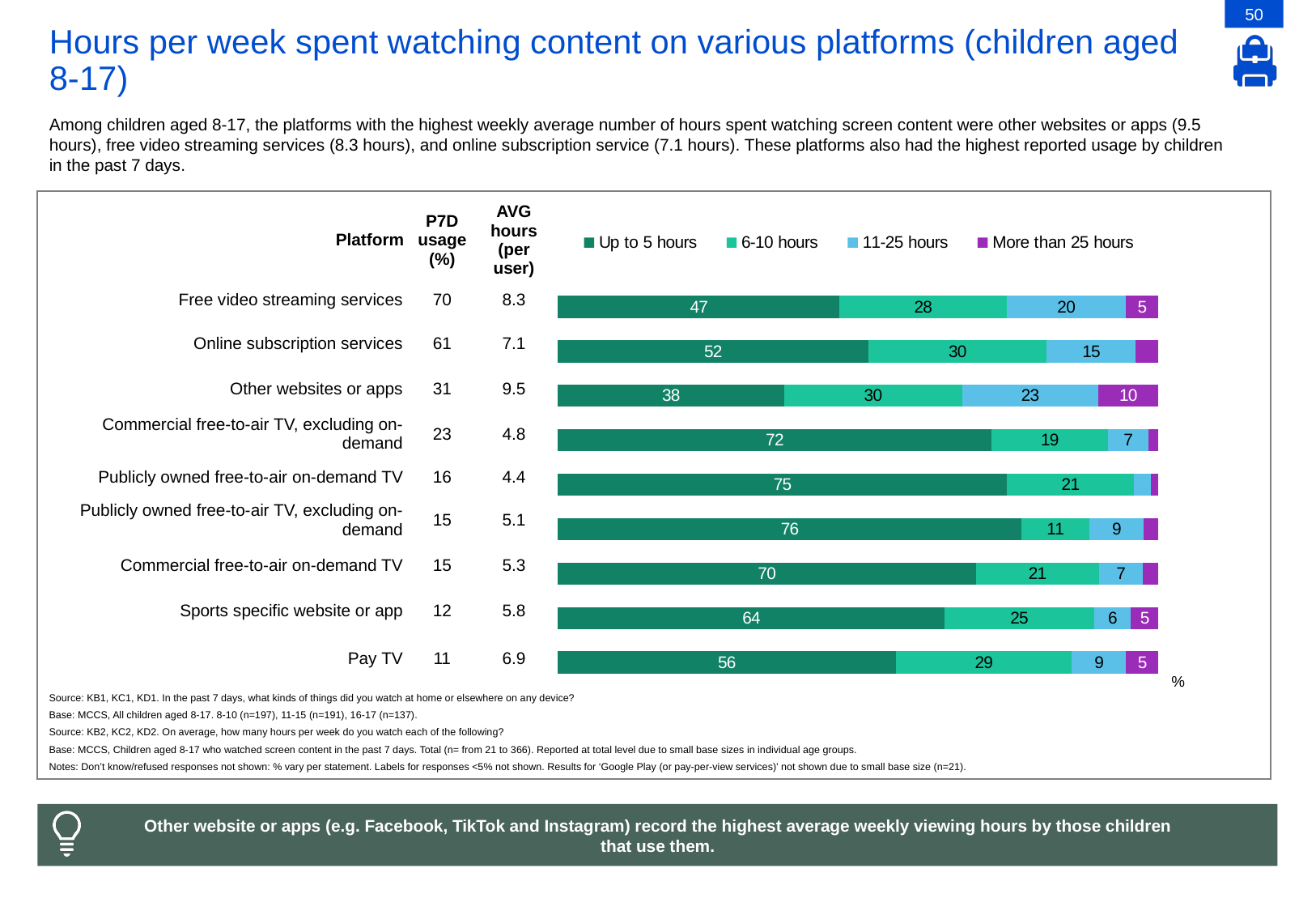
What is the '11-25 hours' value for Free video streaming services? 20 How many series does the legend list? 4 What is the difference between the '6-10 hours' values for Online subscription services and Free video streaming services? 2 What kind of chart is shown on the slide? Stacked bar chart Which platform has the highest 'Up to 5 hours' value? Publicly owned free-to-air TV, excluding on-demand What is the '11-25 hours' value for Pay TV? 9 What colour represents 'Up to 5 hours' in the legend? Dark green What is the 'Up to 5 hours' value for Other websites or apps? 38 Which platform has the lowest 'Up to 5 hours' value? Other websites or apps How many platforms are plotted in the chart? 9 Which has the larger 'More than 25 hours' value, Other websites or apps or Pay TV? Other websites or apps What is the '6-10 hours' value for Sports specific website or app? 25